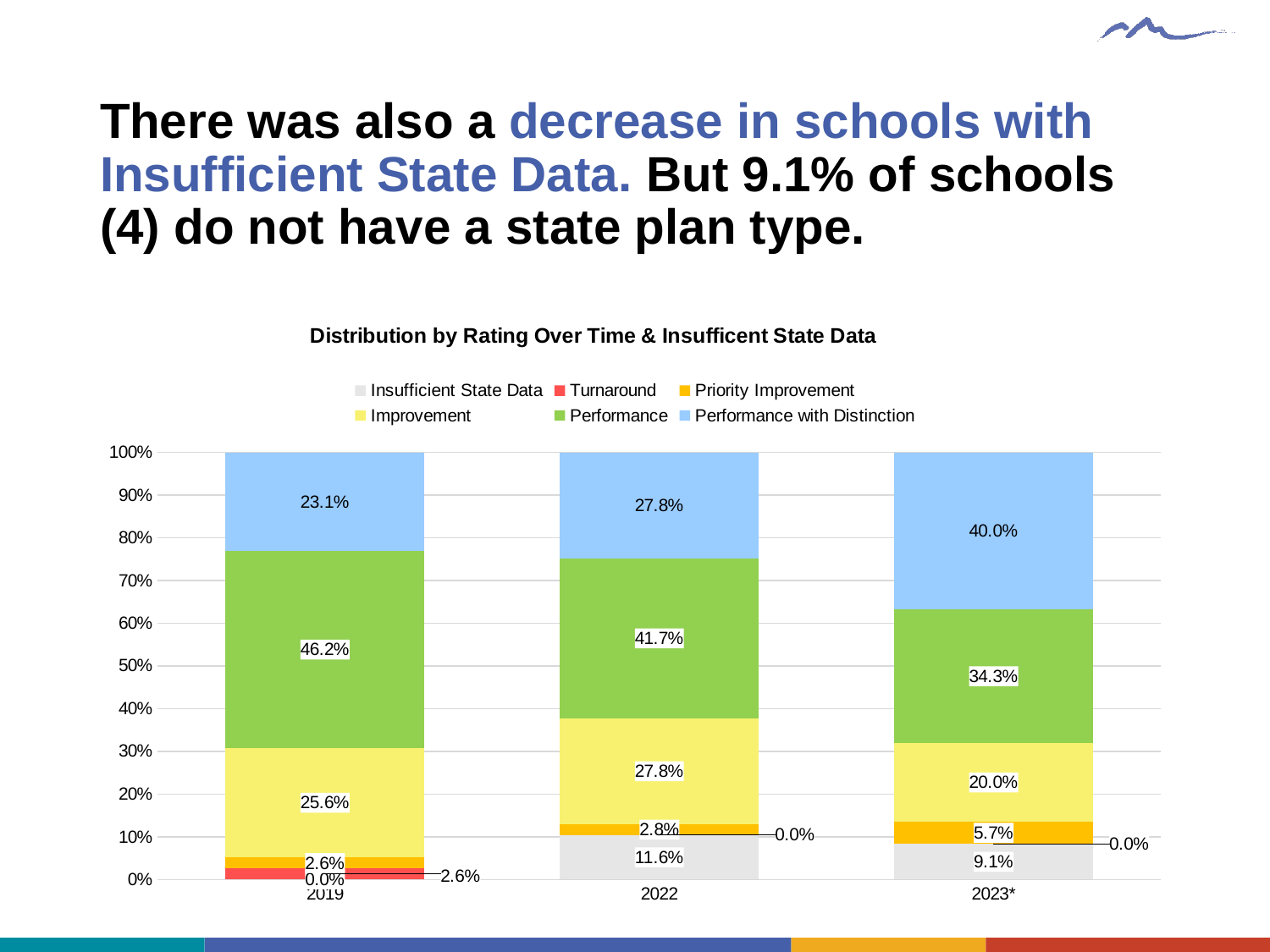
Does the Performance with Distinction value rise or fall from 2019 to 2023*? Rises Which year has the lowest value for Performance? 2023* How many years are shown on the x axis? 3 What is the value for Performance with Distinction in 2023*? 40.0% What is the value for Insufficient State Data in 2022? 11.6% What is the difference between the Performance with Distinction values for 2023* and 2019? 16.9 percentage points Which year has the larger Improvement value, 2022 or 2023*? 2022 How many series does the legend list? 6 Which year has the highest value for Performance with Distinction? 2023* What is the value for Performance in 2019? 46.2% What is the value for Insufficient State Data in 2023*? 9.1% What kind of chart is this? Stacked bar chart